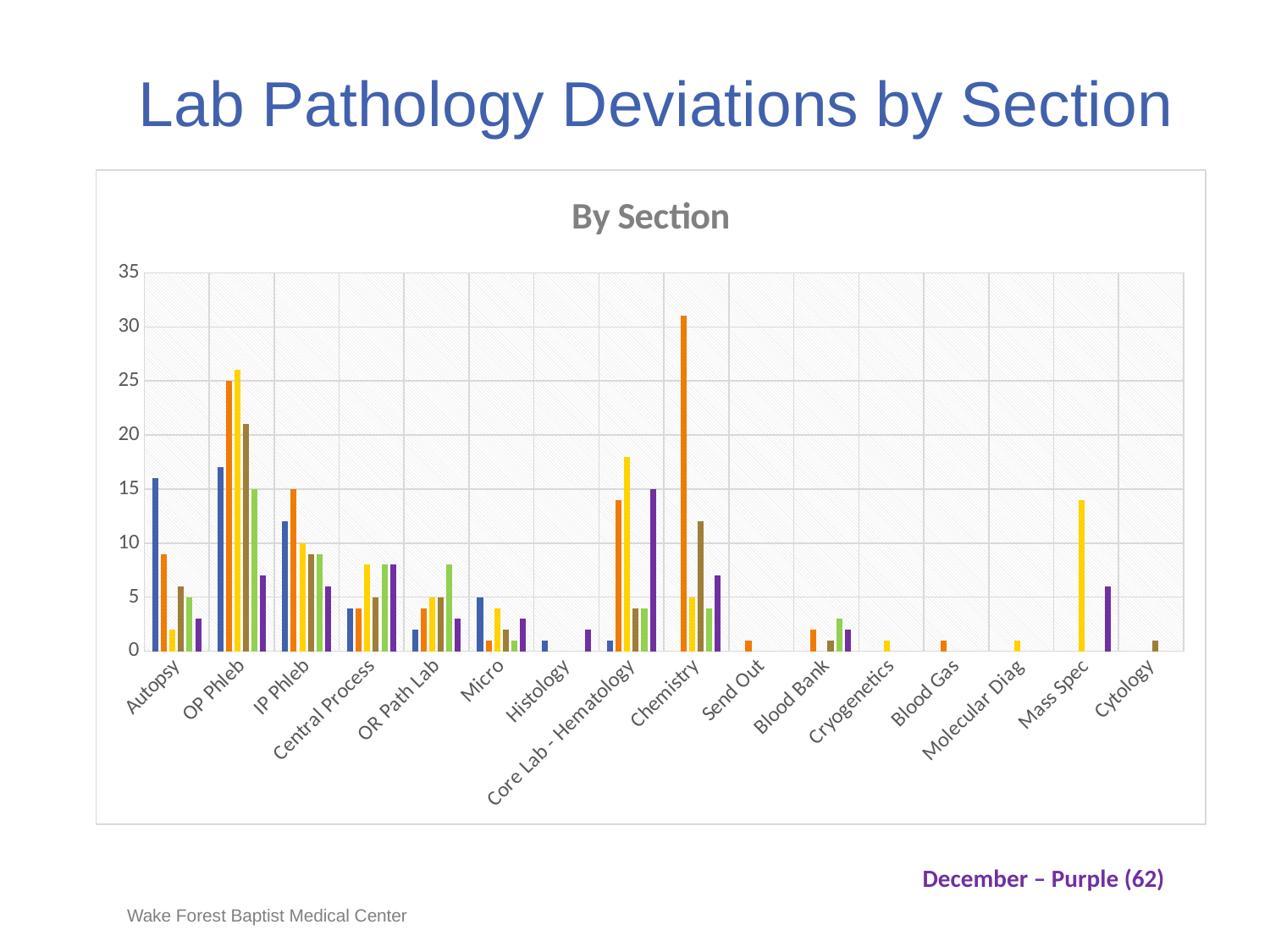
Is the purple bar for Histology greater or less than 5? less Is the yellow bar for Mass Spec greater or less than 10? greater According to the slide, which colour represents December? Purple Which has the taller orange bar, Chemistry or OP Phleb? Chemistry Is the blue bar for Autopsy greater or less than 10? greater Which section has the tallest purple bar? Core Lab - Hematology Which section has the tallest bar in the chart? Chemistry What kind of chart is shown on the slide? bar chart Which has the taller yellow bar, Core Lab - Hematology or Mass Spec? Core Lab - Hematology How many section categories are shown along the x axis? 16 What is the title of the chart? By Section